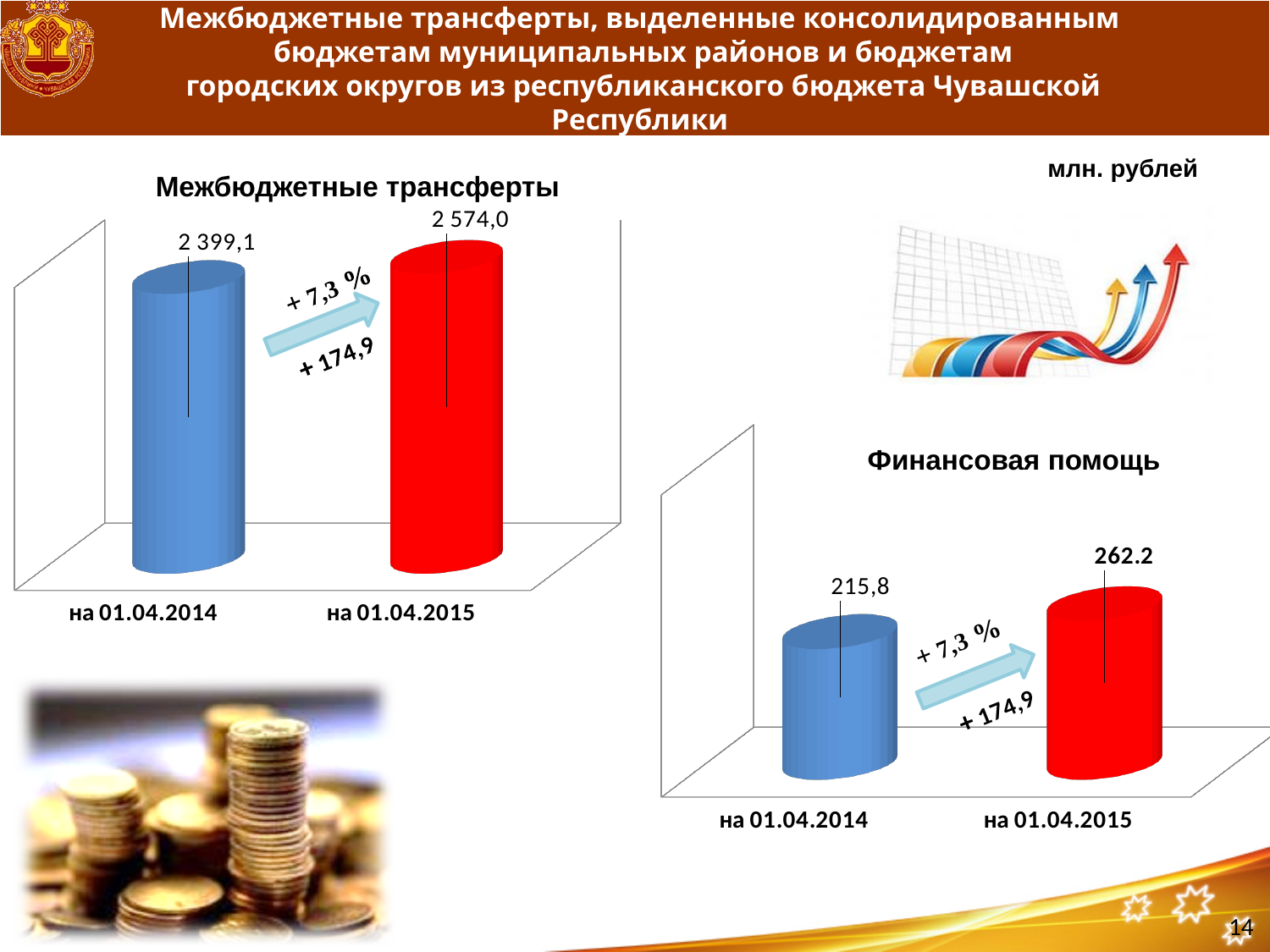
In the 'Межбюджетные трансферты' chart, what is the value for на 01.04.2014? 2 399,1 In the 'Финансовая помощь' chart, what is the value for на 01.04.2015? 262.2 In the 'Межбюджетные трансферты' chart, do the values rise or fall from на 01.04.2014 to на 01.04.2015? rise In the 'Финансовая помощь' chart, what is the value for на 01.04.2014? 215,8 In the 'Финансовая помощь' chart, which date has the lower value? на 01.04.2014 What type of chart is the 'Финансовая помощь' chart? bar chart In the 'Межбюджетные трансферты' chart, which date has the higher value? на 01.04.2015 In the 'Межбюджетные трансферты' chart, what is the value for на 01.04.2015? 2 574,0 How many bars are shown in the 'Межбюджетные трансферты' chart? 2 In the 'Межбюджетные трансферты' chart, what is the difference between the values for на 01.04.2015 and на 01.04.2014? 174,9 In the 'Финансовая помощь' chart, is the value for на 01.04.2015 larger or smaller than the value for на 01.04.2014? larger What percentage change is shown by the arrow in the 'Межбюджетные трансферты' chart? + 7,3 %